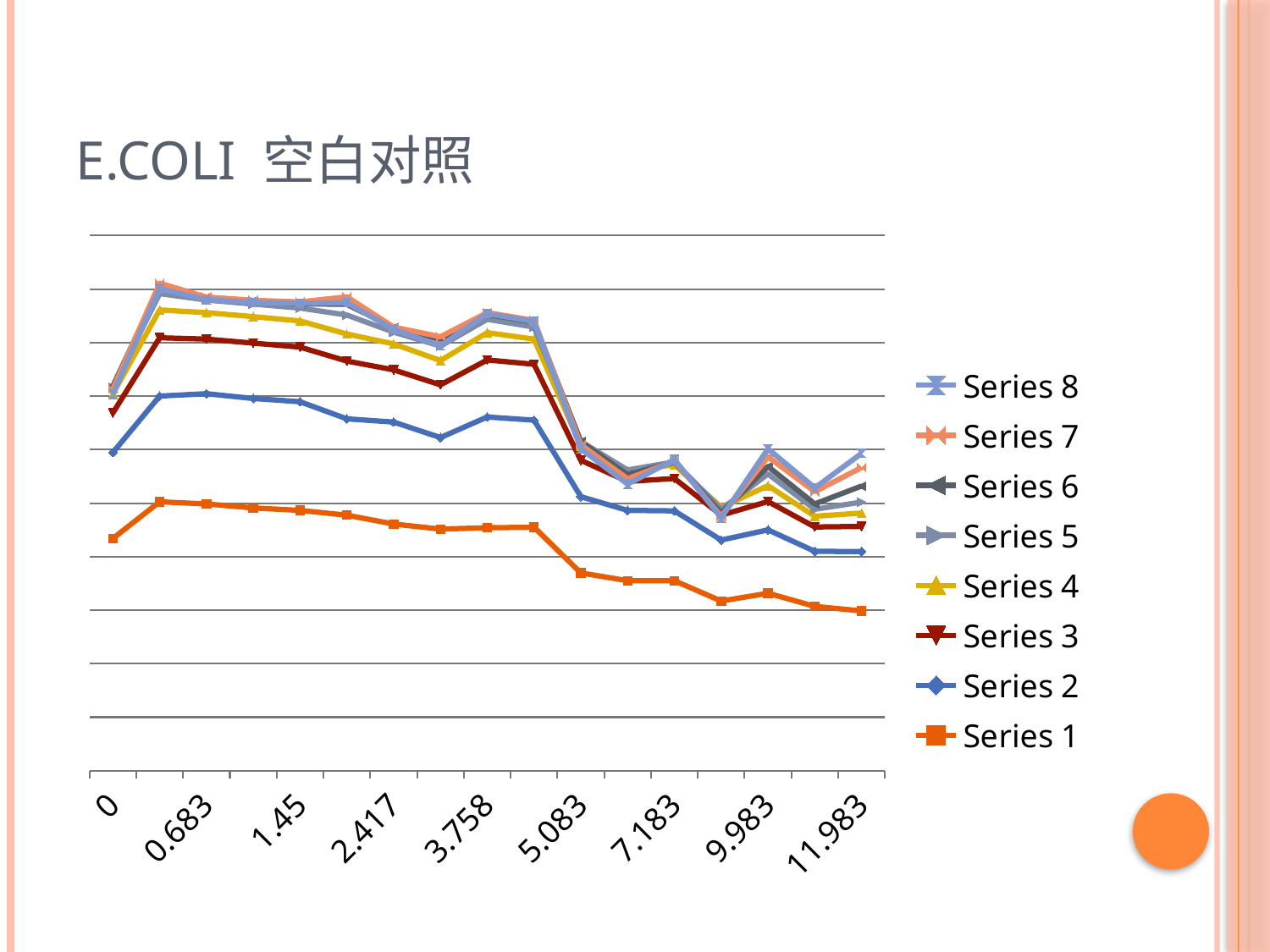
Does Series 2 rise or fall between x = 0 and x = 0.683? rise What kind of chart is shown on the slide? line chart Which series is highest at x = 11.983? Series 8 How many series does the legend list? 8 Does Series 1 rise or fall overall from x = 0.683 to x = 11.983? fall What is the title of the slide? E.COLI 空白对照 Which series is plotted lowest at x = 0? Series 1 Which series is listed first (at the top) in the legend? Series 8